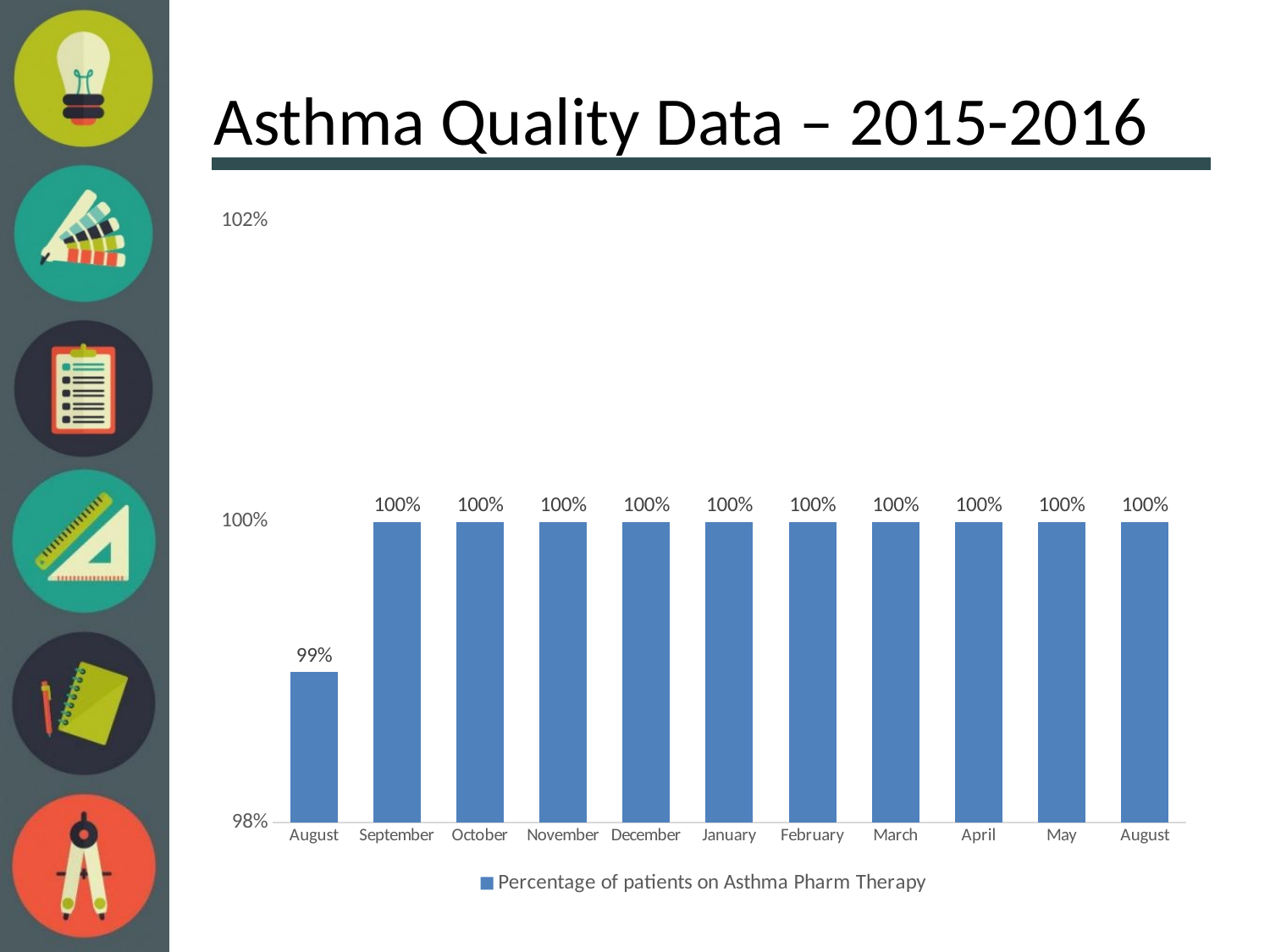
What is the value for May? 100% What is the title of the slide containing the chart? Asthma Quality Data – 2015-2016 How many bars are plotted in the chart? 11 What is the value for the leftmost August bar? 99% Which is larger, the value for March or the value for the leftmost August bar? March What is the value for October? 100% What is the difference between the value for September and the value for the leftmost August bar? 1% Is the value for the leftmost August bar greater or less than 100%? less Which category has the lowest value? August (the leftmost bar) What kind of chart is shown on the slide? bar chart What is the legend entry for the series in the chart? Percentage of patients on Asthma Pharm Therapy How many series does the legend list? 1